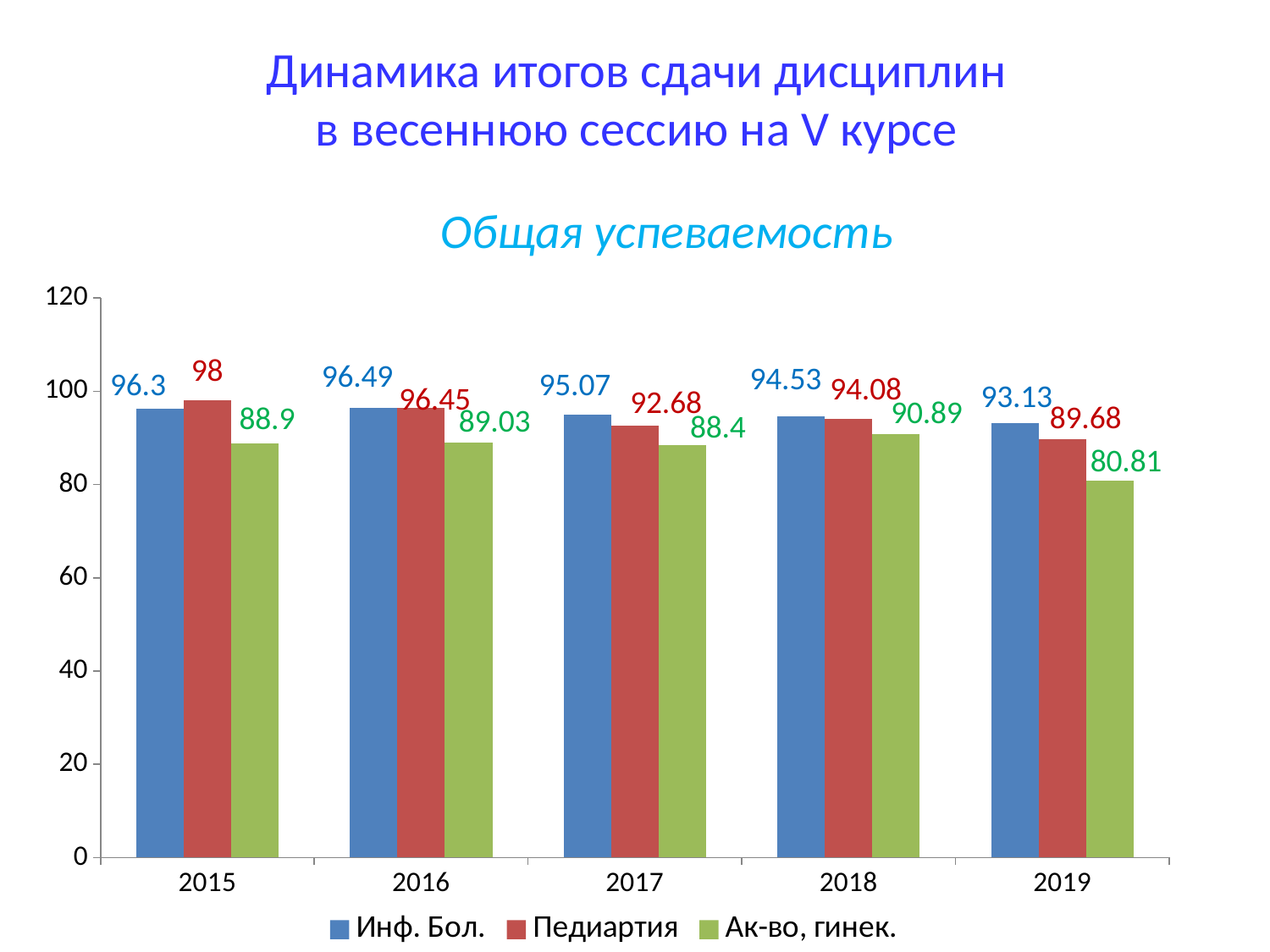
What is the value for Педиартия in 2019? 89.68 Does the Инф. Бол. value rise or fall from 2016 to 2019? fall What is the value for Ак-во, гинек. in 2018? 90.89 Which is larger in 2017: Инф. Бол. or Педиартия? Инф. Бол. In which year is the Ак-во, гинек. value lowest? 2019 What is the value for Инф. Бол. in 2015? 96.3 How many series does the legend list? 3 How many years are shown on the x axis? 5 In which year is the Педиартия value highest? 2015 What kind of chart is shown? bar chart Is the value for Ак-во, гинек. in 2019 greater or less than 100? less What is the difference between the Педиартия and Ак-во, гинек. values in 2015? 9.1